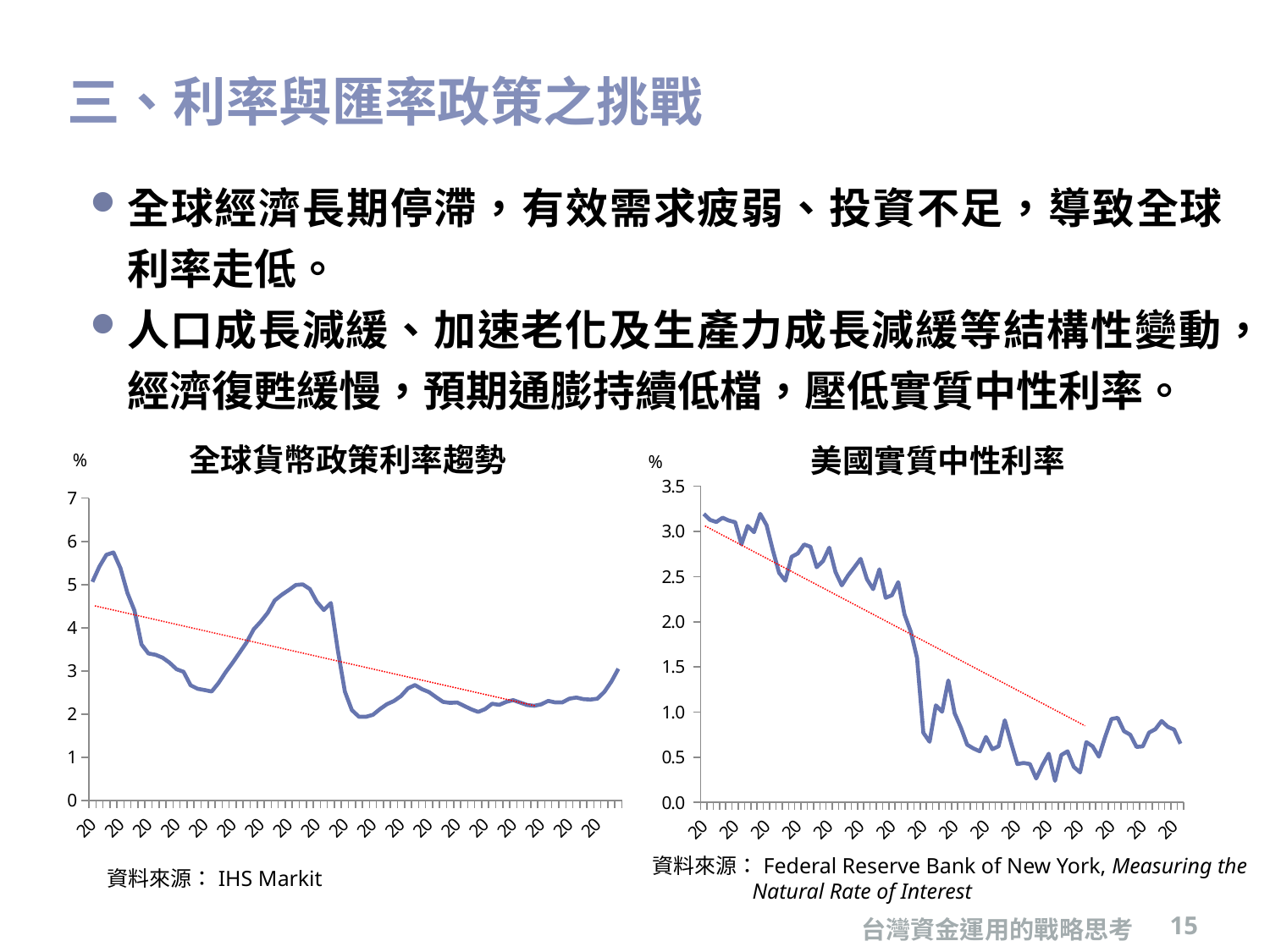
In the right chart (美國實質中性利率), is the lowest point of the line greater or less than 0.5? less In the left chart (全球貨幣政策利率趨勢), is the highest point of the line greater or less than 5? greater In the right chart (美國實質中性利率), is the first point of the line greater or less than 3.0? greater What kind of chart is the right chart titled 美國實質中性利率? line chart In the right chart (美國實質中性利率), do the values overall rise or fall from left to right along the x axis? fall What kind of chart is the left chart titled 全球貨幣政策利率趨勢? line chart In the left chart (全球貨幣政策利率趨勢), do the values overall rise or fall from left to right along the x axis? fall What is the title of the left chart? 全球貨幣政策利率趨勢 What unit is shown on the y axis of the right chart (美國實質中性利率)? %